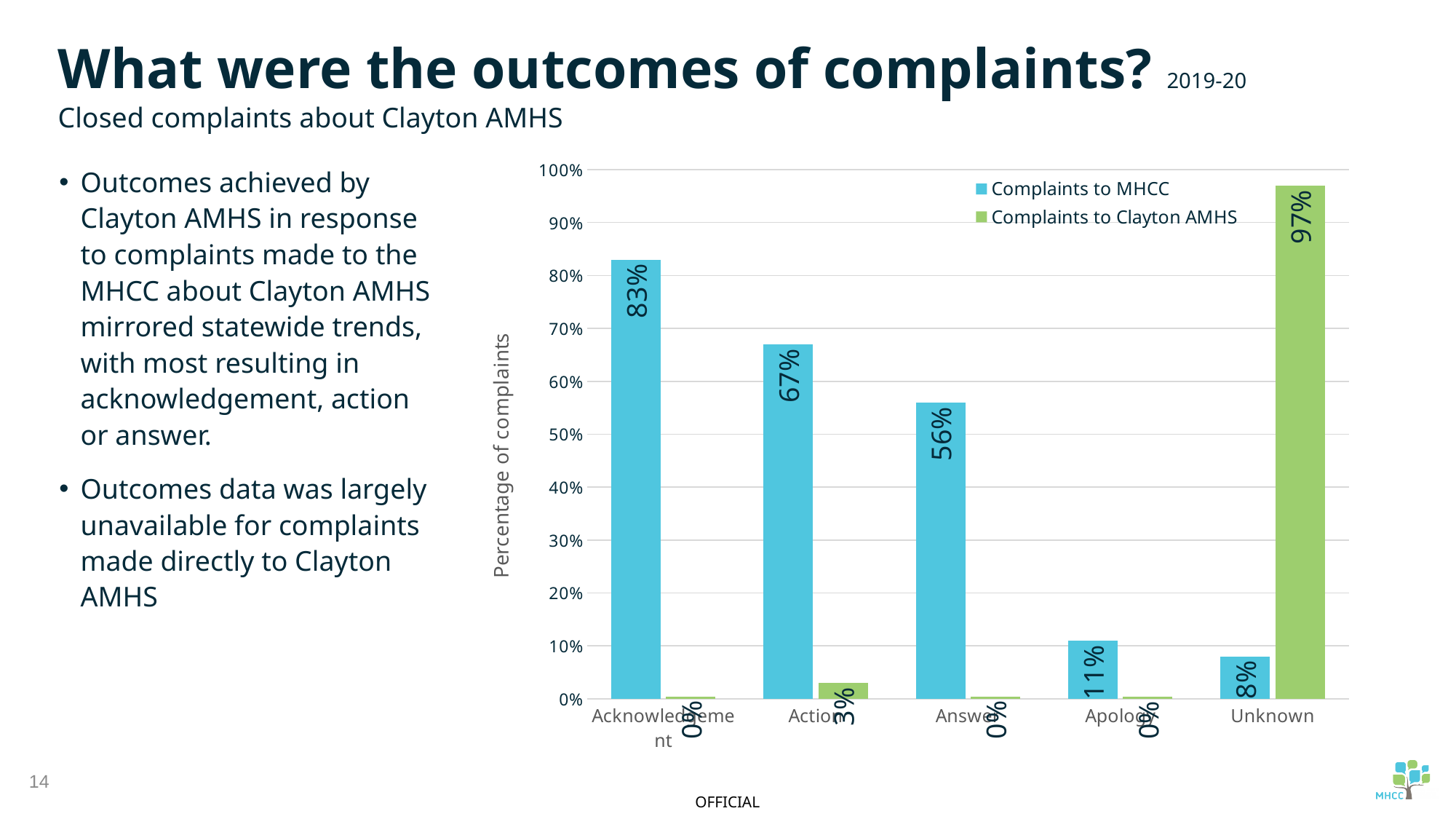
What percentage of complaints to Clayton AMHS resulted in Action? 3% What percentage of complaints to Clayton AMHS had an Unknown outcome? 97% What percentage of complaints to MHCC resulted in Acknowledgement? 83% For the Unknown category, which series has the larger value: Complaints to MHCC or Complaints to Clayton AMHS? Complaints to Clayton AMHS Which outcome category has the highest value for Complaints to MHCC? Acknowledgement How many series does the legend list? 2 What is the difference between the Complaints to MHCC values for Acknowledgement and Action? 16% How many outcome categories are shown on the x axis? 5 What percentage of complaints to MHCC resulted in Apology? 11% What is the label of the vertical axis? Percentage of complaints Which outcome category has the lowest value for Complaints to MHCC? Unknown What kind of chart is shown on the slide? Bar chart